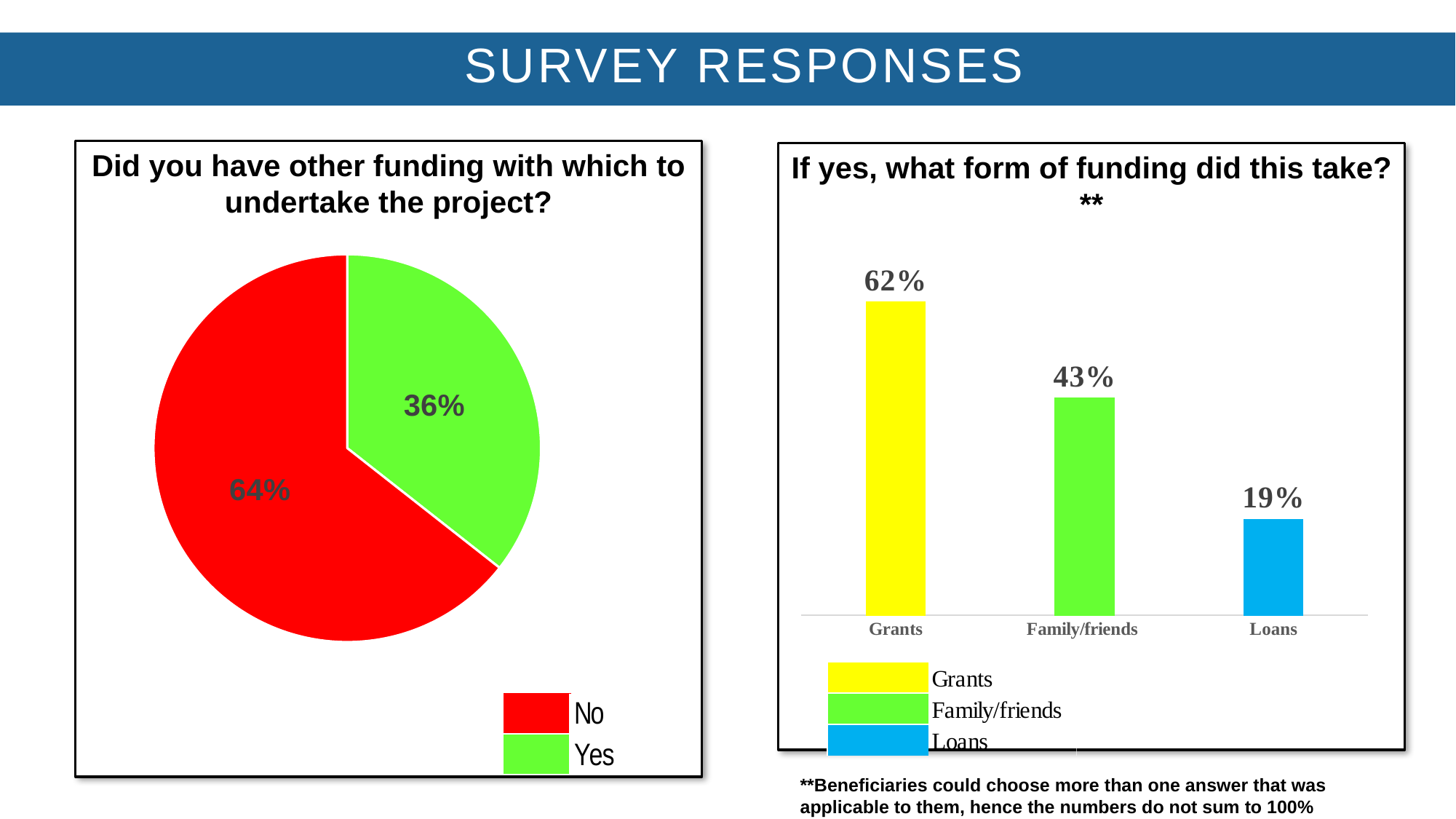
In the pie chart on the left, which response has the larger share, No or Yes? No In the chart 'If yes, what form of funding did this take?', what is the value for Family/friends? 43% In the pie chart on the left, what is the difference in percentage points between the No and Yes shares? 28 In the pie chart 'Did you have other funding with which to undertake the project?', what share of respondents answered No? 64% In the chart 'If yes, what form of funding did this take?', what is the difference between the Grants and Loans values? 43% In the pie chart on the left, what colour is the Yes slice? Green What kind of chart is the chart on the right of the slide? Bar chart What kind of chart is the chart on the left of the slide? Pie chart In the pie chart 'Did you have other funding with which to undertake the project?', what share of respondents answered Yes? 36% In the chart 'If yes, what form of funding did this take?', what is the value for Loans? 19% In the chart 'If yes, what form of funding did this take?', which form of funding has the lowest value? Loans In the chart 'If yes, what form of funding did this take?', what is the value for Grants? 62%